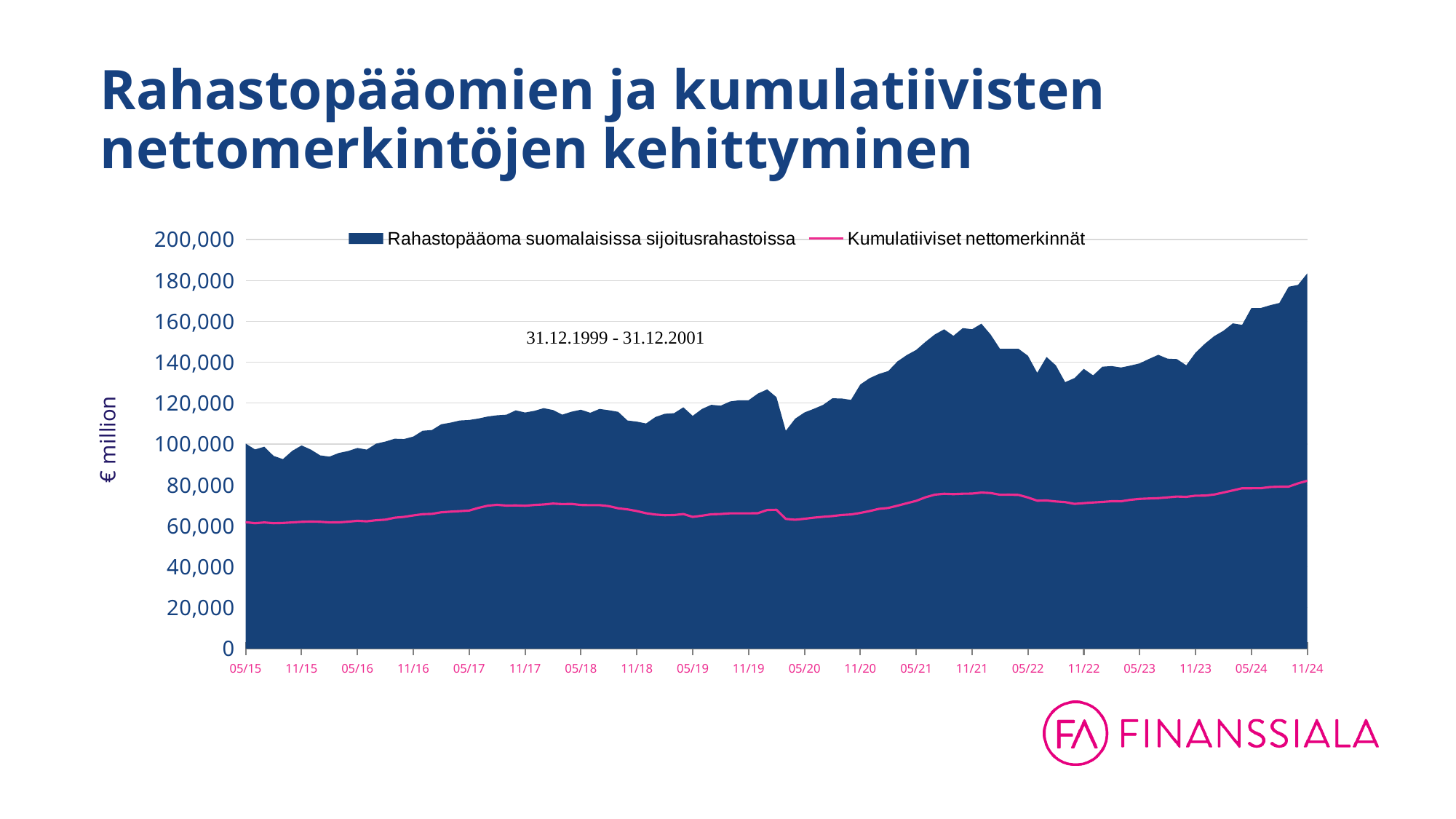
How many date labels are shown on the x axis? 20 Which series is drawn as the pink line? Kumulatiiviset nettomerkinnät At 11/24, which is larger: Rahastopääoma suomalaisissa sijoitusrahastoissa or Kumulatiiviset nettomerkinnät? Rahastopääoma suomalaisissa sijoitusrahastoissa Is the value of Kumulatiiviset nettomerkinnät at 11/24 greater or less than 60,000? greater At which x-axis label does Rahastopääoma suomalaisissa sijoitusrahastoissa reach its highest value? 11/24 Is the value of Rahastopääoma suomalaisissa sijoitusrahastoissa at 05/15 greater or less than 120,000? less What kind of chart is shown on the slide? Area chart with a line series How many series does the legend list? 2 What is the unit shown on the vertical axis label? € million Is the value of Kumulatiiviset nettomerkinnät at 05/15 greater or less than 80,000? less Overall, does Rahastopääoma suomalaisissa sijoitusrahastoissa rise or fall from 05/15 to 11/24? rise